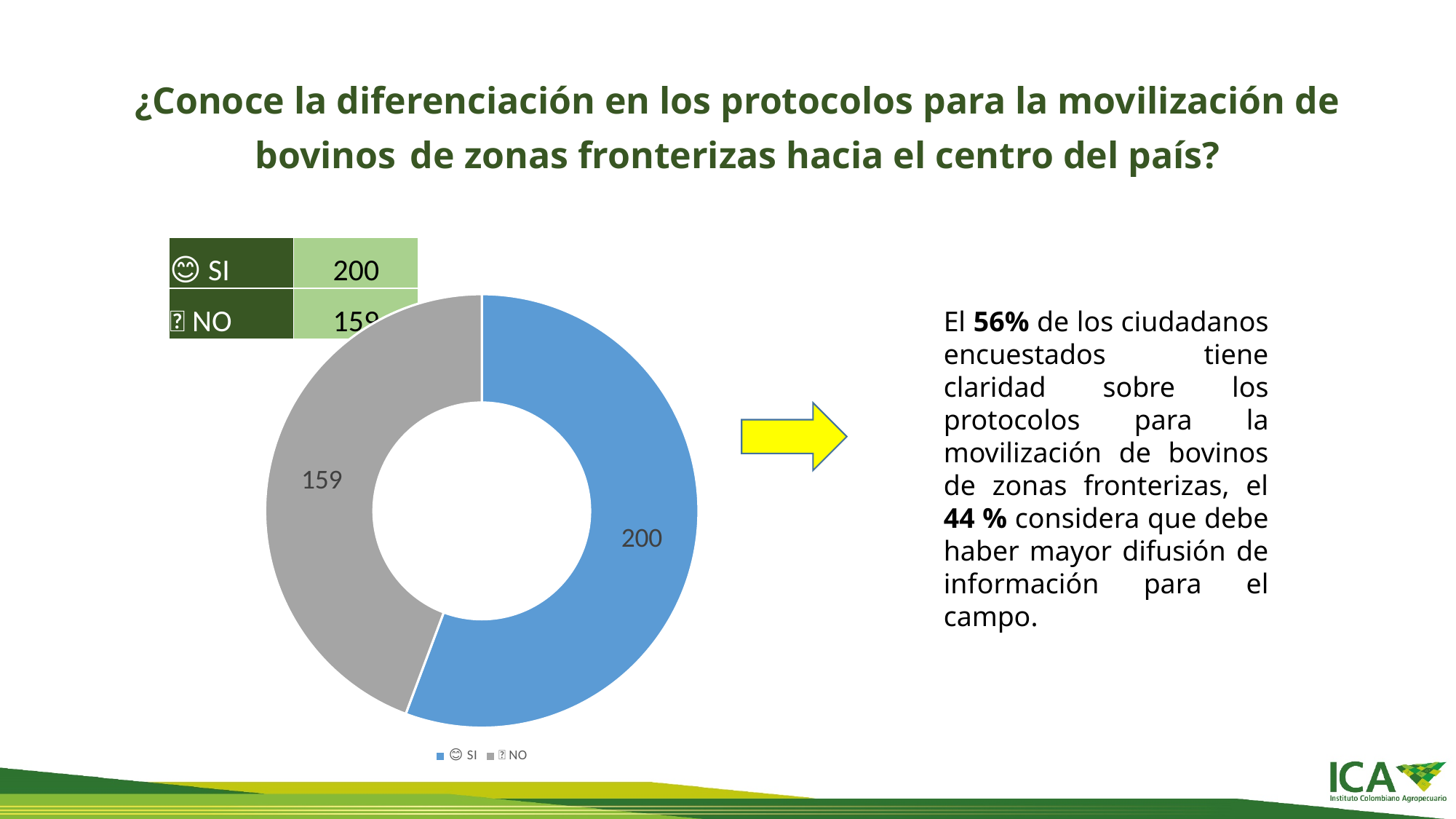
What colour is the SI slice in the doughnut chart? blue Which category has the smaller value in the chart? NO What share of the total does the SI slice represent, as stated on the slide? 56% What kind of chart is shown on the slide? doughnut chart Which category has the larger value in the chart, SI or NO? SI What is the difference between the SI and NO values in the chart? 41 How many categories does the doughnut chart show? 2 What is the value for NO in the doughnut chart? 159 Is the value for SI larger or smaller than the value for NO? larger How many entries does the chart legend list? 2 What is the value for SI in the doughnut chart? 200 What is the total of the two values shown in the chart? 359